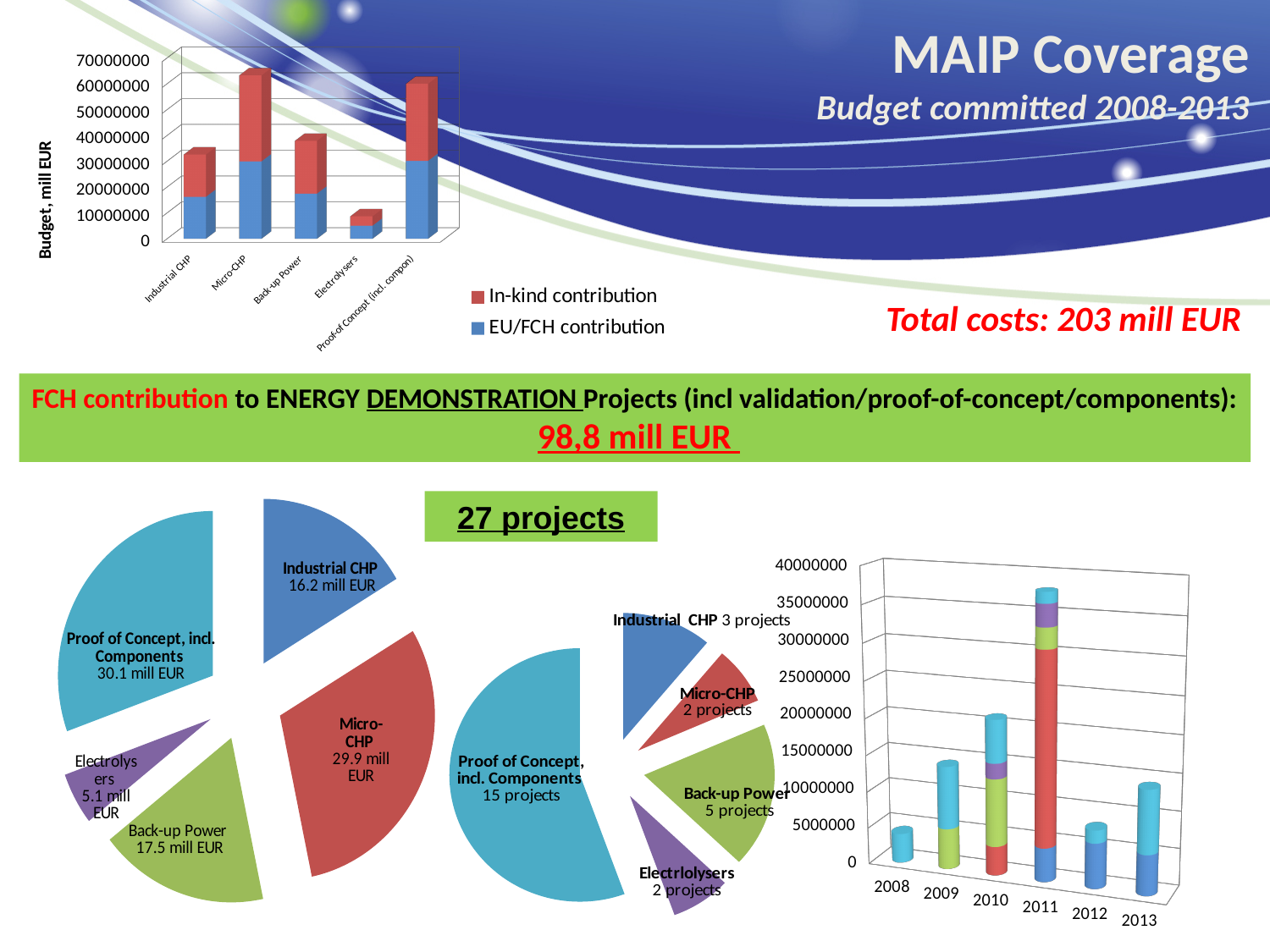
In the bottom-left pie chart (mill EUR by technology), what is the value for Micro-CHP? 29.9 mill EUR In the top-left bar chart, is the total value for Micro-CHP greater or less than 50000000? greater In the top-left bar chart, which category has the tallest total bar? Micro-CHP In the bottom-left pie chart (mill EUR by technology), what is the difference between Micro-CHP and Industrial CHP? 13.7 mill EUR In the bottom-right bar chart by year, is the value for 2008 greater or less than 5000000? less In the top-left bar chart, how many series does the legend list? 2 In the top-left bar chart, which category has the shortest total bar? Electrolysers In the bottom-right bar chart by year, which year has the tallest bar? 2011 In the bottom-left pie chart (mill EUR by technology), which category has the smallest value? Electrolysers In the bottom-middle pie chart (number of projects), which category has the most projects? Proof of Concept, incl. Components What type of chart is the top-left chart showing Budget, mill EUR by technology area? bar chart In the bottom-middle pie chart (number of projects), how many projects does Back-up Power have? 5 projects